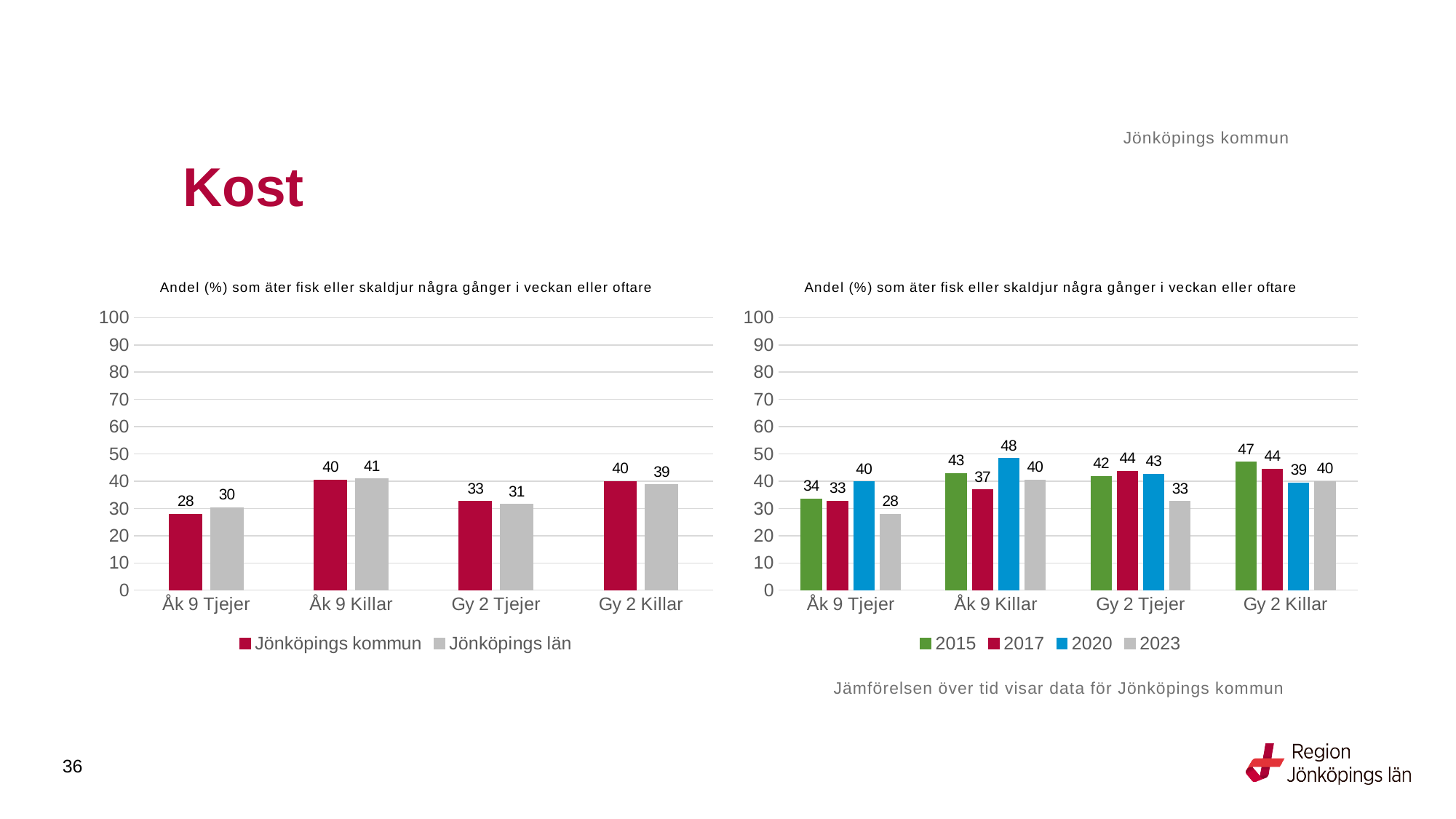
In the left chart, what is the difference between Jönköpings kommun and Jönköpings län for Gy 2 Tjejer? 2 In the right chart, is the value for 2017 for Gy 2 Tjejer larger or smaller than the value for 2023 for Gy 2 Tjejer? larger In the right chart, what is the value for 2020 for Åk 9 Killar? 48 In the left chart, what is the value for Jönköpings län for Gy 2 Killar? 39 In the right chart, what is the value for 2015 for Gy 2 Killar? 47 In the right chart, how many series does the legend list? 4 In the left chart, which category has the lowest value for Jönköpings kommun? Åk 9 Tjejer In the left chart, what is the value for Jönköpings kommun for Åk 9 Tjejer? 28 In the right chart, what is the difference between the 2015 and 2023 values for Gy 2 Killar? 7 In the left chart, how many series does the legend list? 2 In the right chart, which category has the highest value for 2023? Åk 9 Killar and Gy 2 Killar (both 40) What kind of chart is the right chart? bar chart